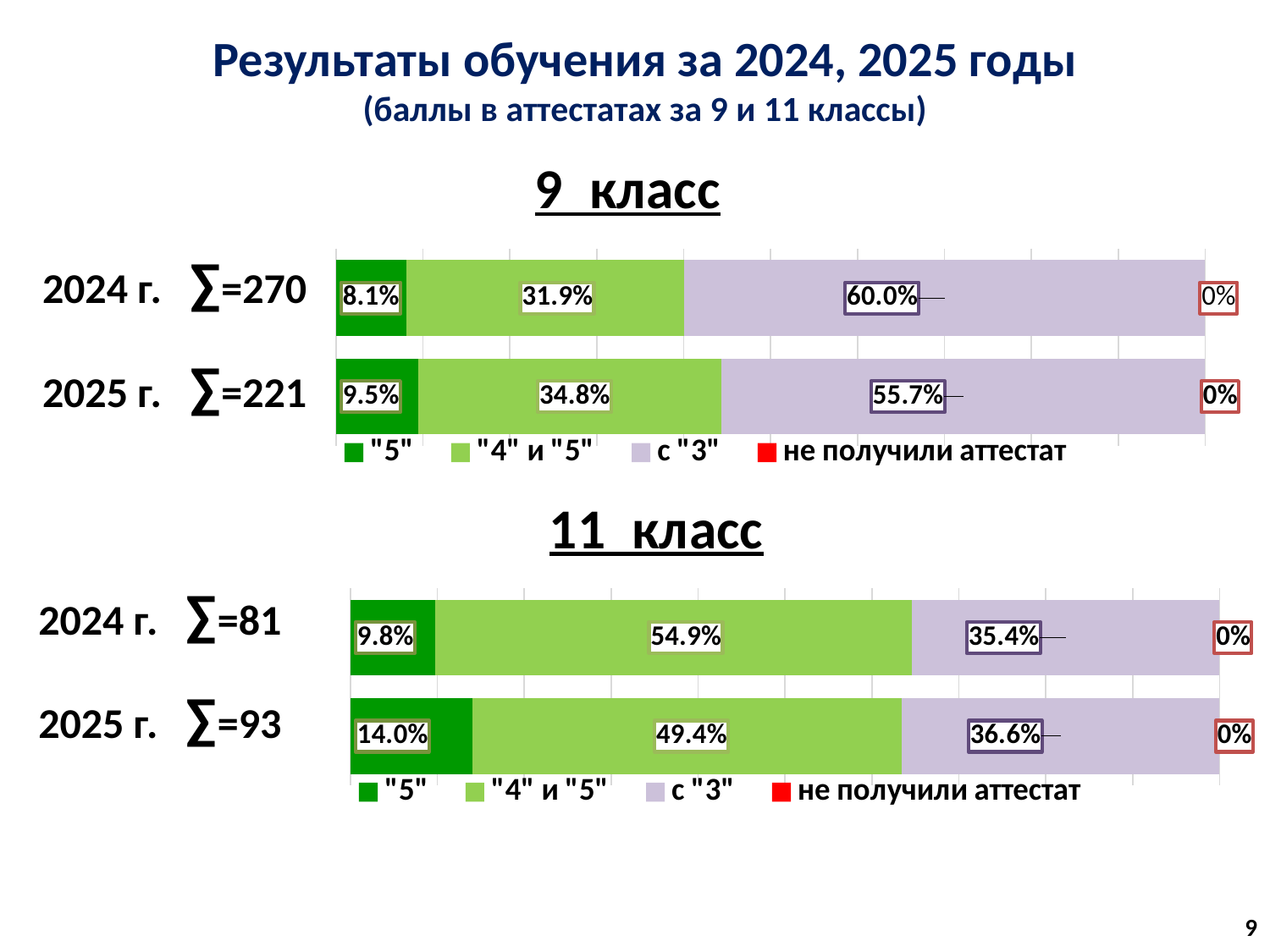
In the "9 класс" chart, which segment is the largest in the 2024 г. bar? с "3" How many bars are plotted in the "11 класс" chart? 2 In the "9 класс" chart, what is the value for "5" in 2024 г.? 8.1% In the "9 класс" chart, what is the difference between the "4" и "5" values for 2025 г. and 2024 г.? 2.9% In the "9 класс" chart, what is the value for с "3" in 2025 г.? 55.7% How many series does the legend of the "9 класс" chart list? 4 In the "11 класс" chart, which segment is the smallest non-zero value in the 2024 г. bar? "5" In the "11 класс" chart, what is the value for не получили аттестат in 2025 г.? 0% In the "11 класс" chart, what is the value for "4" и "5" in 2024 г.? 54.9% What kind of chart is the "9 класс" chart? Stacked bar chart In the "11 класс" chart, what is the value for "5" in 2025 г.? 14.0% In the "11 класс" chart, which year has the larger value for с "3": 2024 г. or 2025 г.? 2025 г.